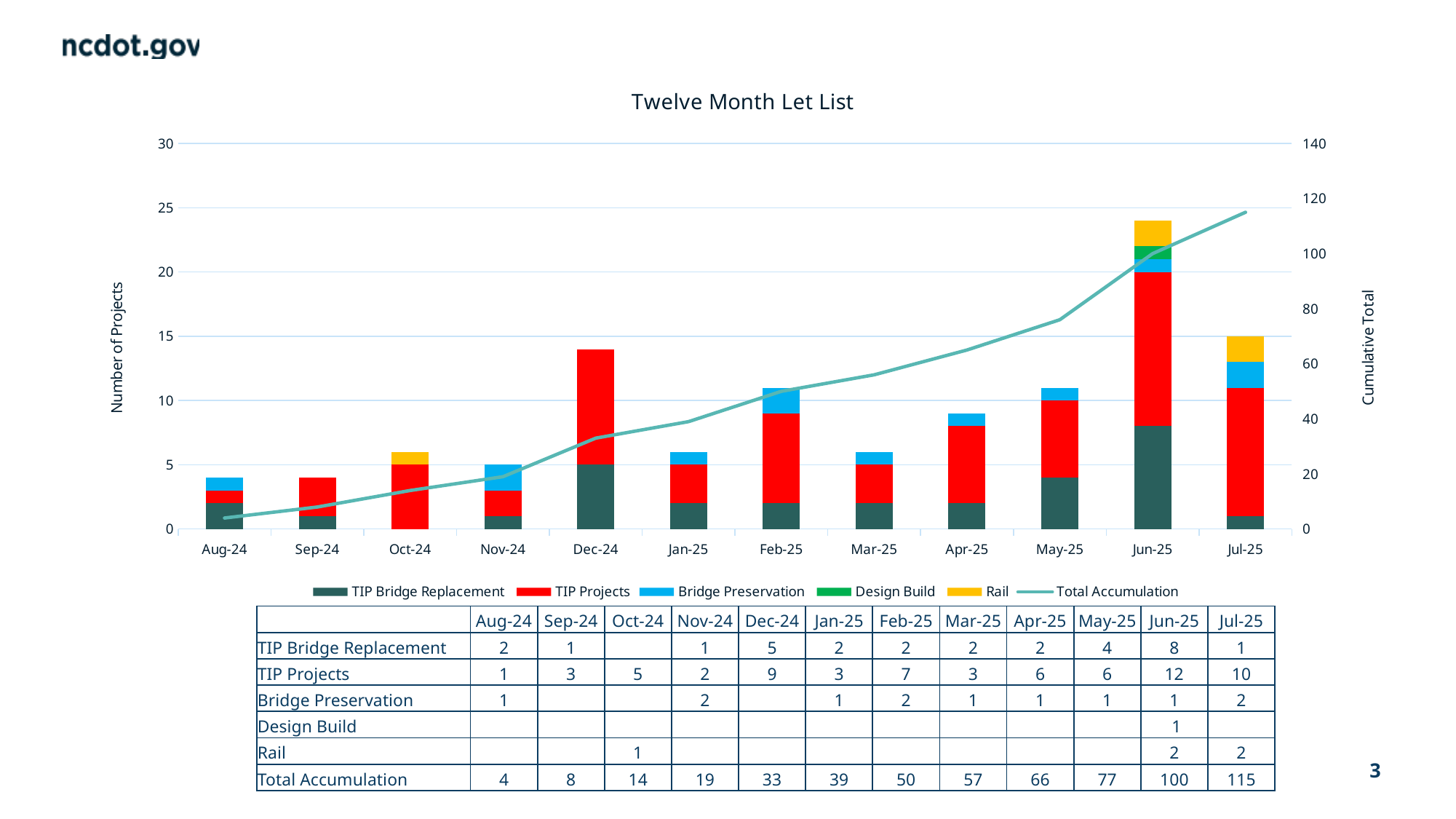
What is the difference between the TIP Projects values for Jun-25 and Jul-25? 2 What is the title of the chart? Twelve Month Let List How many series does the legend list? 6 Which is larger, the TIP Bridge Replacement value for Dec-24 or for May-25? Dec-24 What is the TIP Projects value for Dec-24? 9 Does the Total Accumulation line rise or fall from Aug-24 to Jul-25? rise What is the total height of the stacked bar for Jun-25? 24 What is the TIP Bridge Replacement value for Jun-25? 8 Which month has the highest total number of projects in the stacked bars? Jun-25 What is the Total Accumulation value for Jul-25? 115 What is the total height of the stacked bar for Jul-25? 15 How many months are shown on the x axis? 12